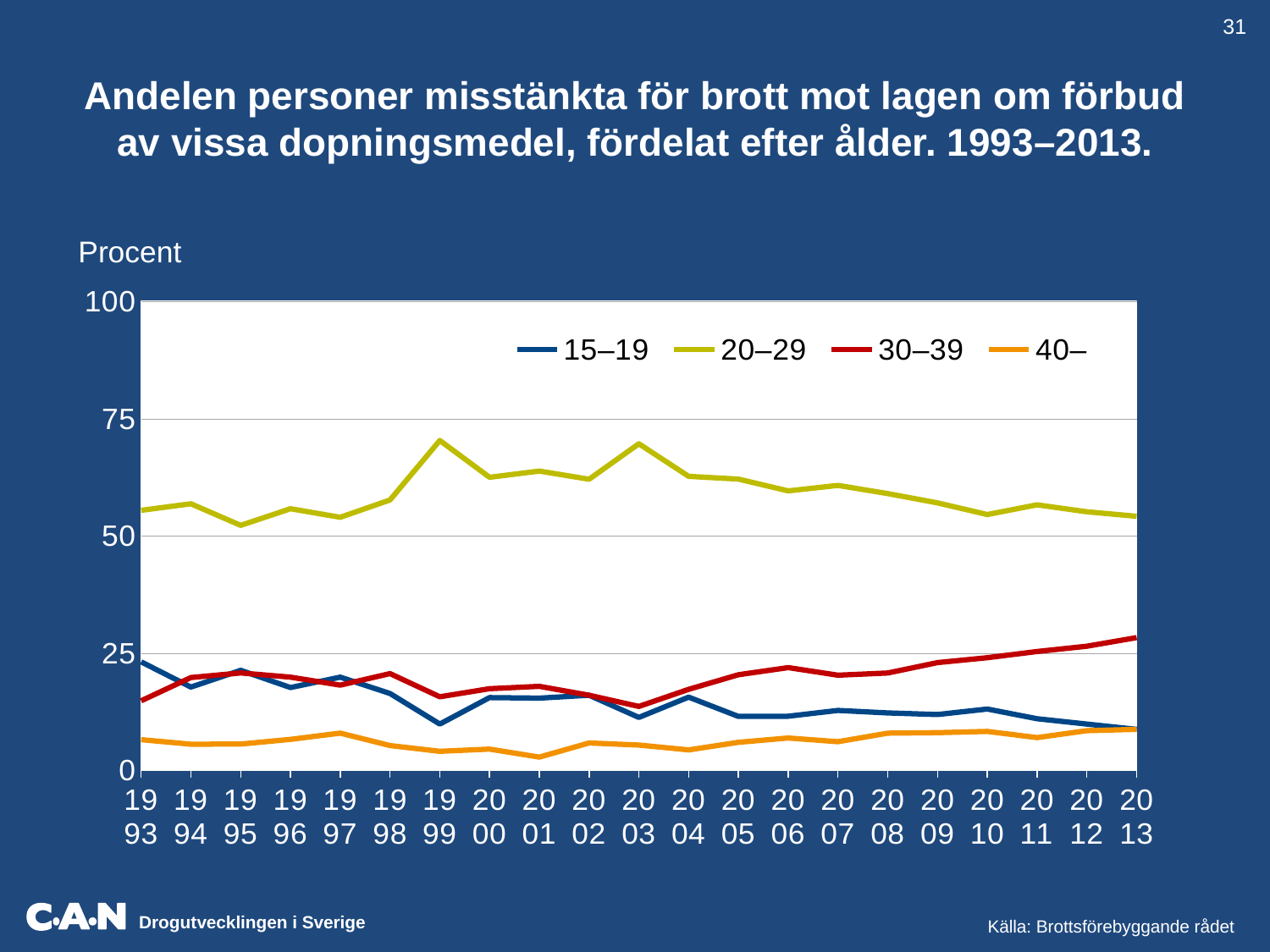
What label is shown above the y axis? Procent Which age group has the lowest share in 1999? 40– Is the value for the 15–19 group in 2013 greater or less than 25? less What kind of chart is shown on the slide? line chart How many series does the legend list? 4 Is the value for the 40– group in 2001 greater or less than 25? less How many years are plotted along the x axis? 21 Which age group has the highest share in 2013? 20–29 Is the value for the 20–29 group in 1999 greater or less than 50? greater In 2013, which is larger: the value for 30–39 or the value for 15–19? 30–39 Does the 30–39 line rise or fall from 2003 to 2013? rise In 1993, which is larger: the value for 15–19 or the value for 30–39? 15–19